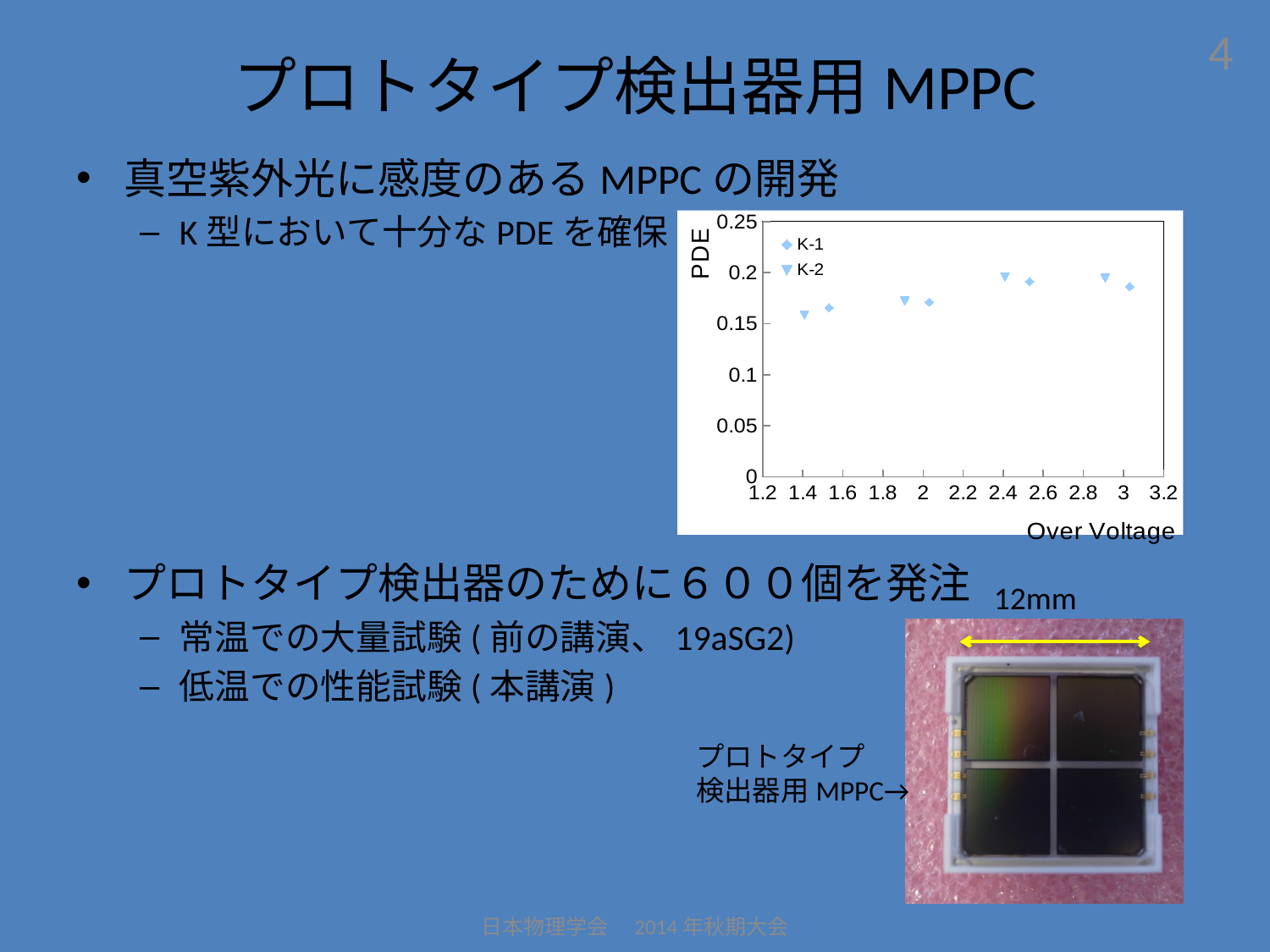
Is the PDE value for K-2 at an over voltage of about 2.4 greater or less than 0.15? greater Do the PDE values generally rise or fall as Over Voltage increases? rise How many data points are plotted for the K-1 series? 4 Is the PDE value for K-2 at an over voltage of about 1.4 greater or less than 0.1? greater How many series does the chart legend list? 2 What is the maximum value shown on the PDE axis? 0.25 How many data points are plotted for the K-2 series? 4 What are the names of the two series in the chart legend? K-1 and K-2 What is the label of the vertical axis of the chart? PDE Is the PDE value for K-1 at the lowest plotted over voltage (around 1.5) greater or less than 0.2? less What kind of chart is shown on the slide? scatter chart